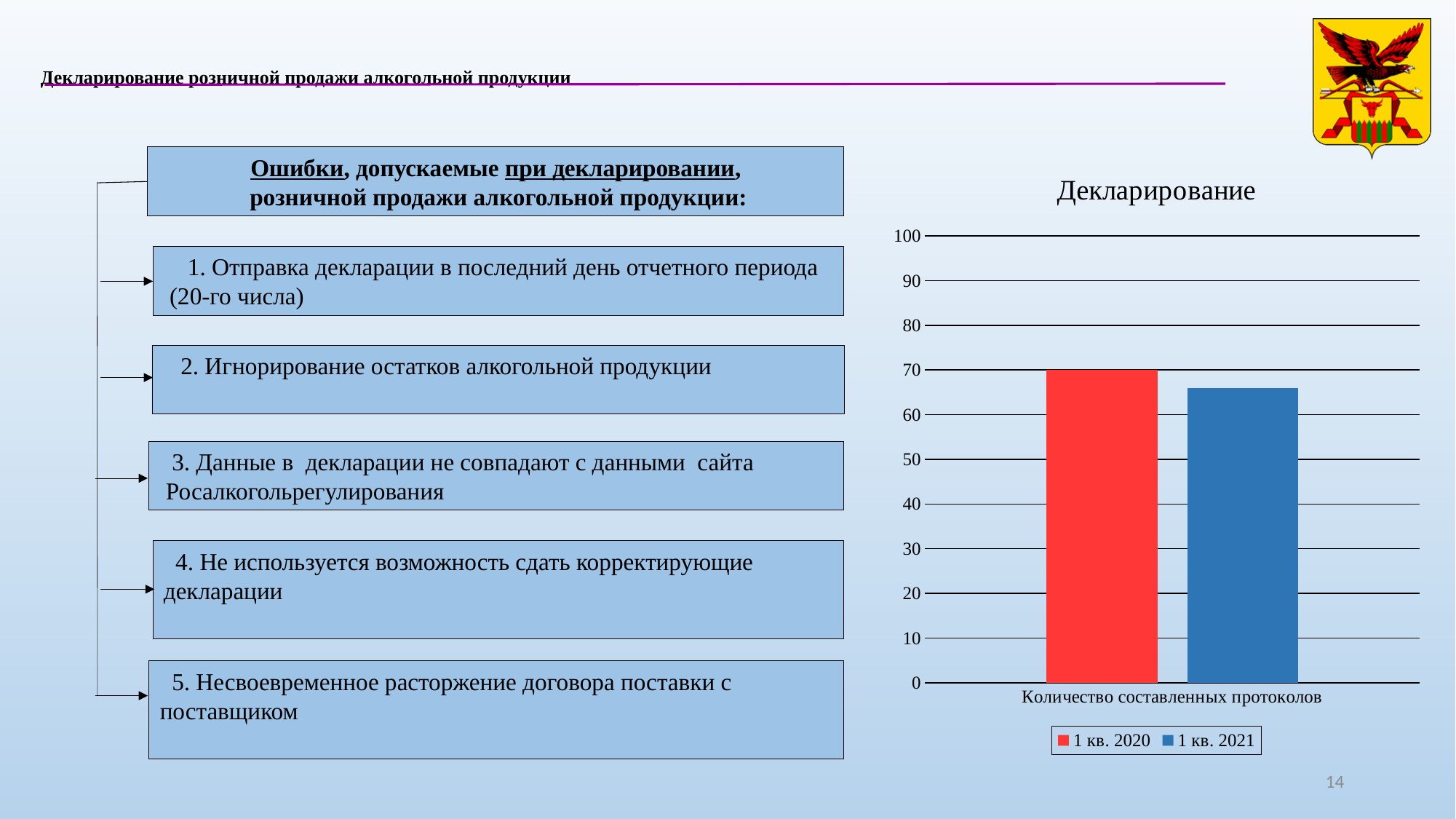
How many series does the chart legend list? 2 Is the value for 1 кв. 2020 greater or less than 80? less What is the value for 1 кв. 2020 in the chart? 70 Is the value for 1 кв. 2021 greater or less than 60? greater What kind of chart is shown on the slide? bar chart Which series has the higher value: 1 кв. 2020 or 1 кв. 2021? 1 кв. 2020 How many categories are shown on the x axis of the chart? 1 Which series has the lowest value in the chart? 1 кв. 2021 Is the value for 1 кв. 2021 greater or less than 70? less What is the category label on the x axis of the chart? Количество составленных протоколов Did the number of protocols rise or fall from 1 кв. 2020 to 1 кв. 2021? fall What is the title of the chart? Декларирование